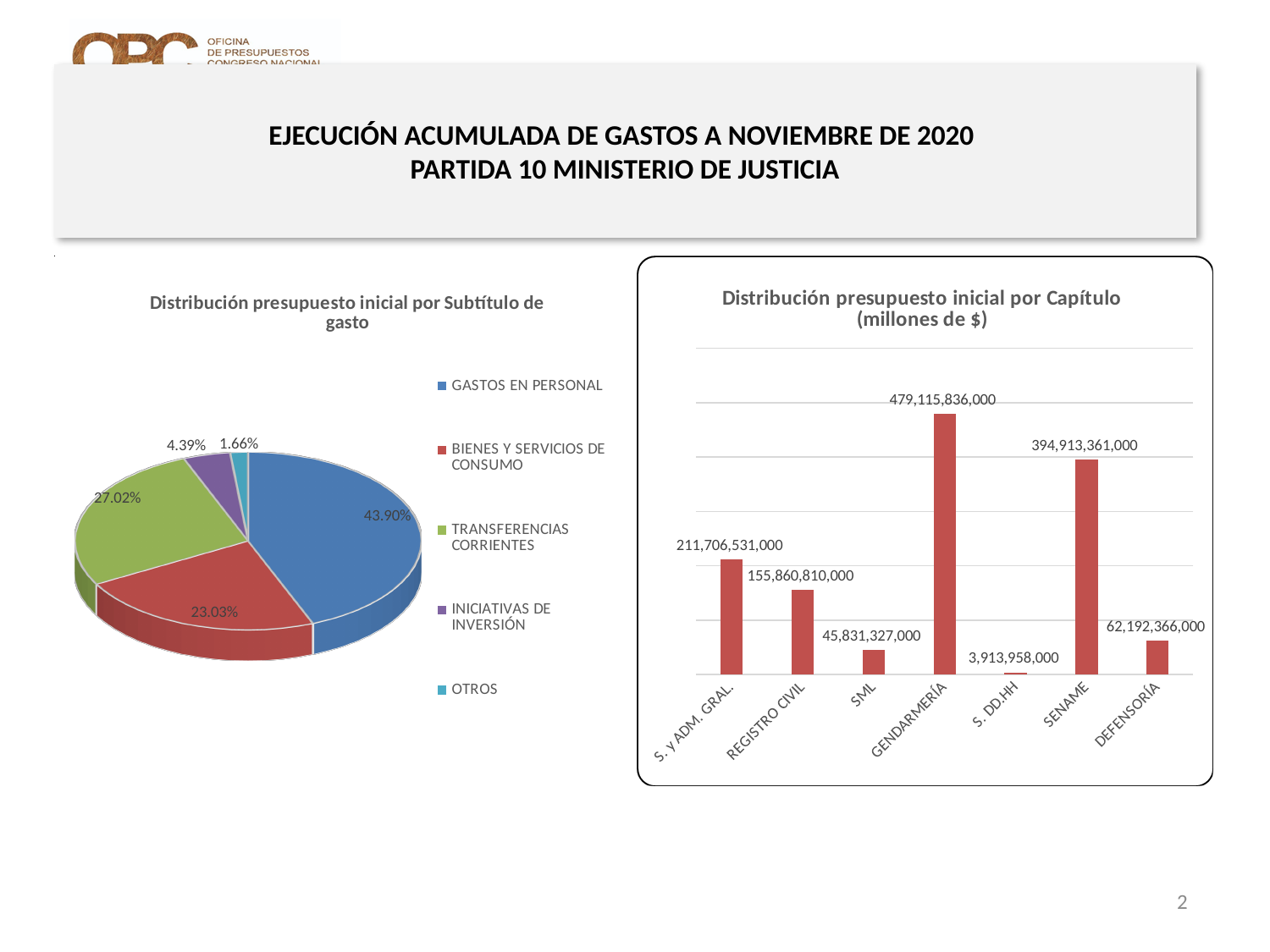
How many categories are shown in the chart 'Distribución presupuesto inicial por Capítulo (millones de $)'? 7 In the chart 'Distribución presupuesto inicial por Capítulo (millones de $)', what is the value for S. DD.HH? 3,913,958,000 What kind of chart is 'Distribución presupuesto inicial por Capítulo (millones de $)'? Bar chart In the chart 'Distribución presupuesto inicial por Capítulo (millones de $)', which category has the highest value? GENDARMERÍA In the chart 'Distribución presupuesto inicial por Capítulo (millones de $)', which category has the lowest value? S. DD.HH In the chart 'Distribución presupuesto inicial por Capítulo (millones de $)', which is larger, the value for REGISTRO CIVIL or the value for DEFENSORÍA? REGISTRO CIVIL In the pie chart 'Distribución presupuesto inicial por Subtítulo de gasto', what share does TRANSFERENCIAS CORRIENTES have? 27.02% In the chart 'Distribución presupuesto inicial por Capítulo (millones de $)', what is the value for SENAME? 394,913,361,000 How many entries does the legend of the pie chart 'Distribución presupuesto inicial por Subtítulo de gasto' list? 5 In the chart 'Distribución presupuesto inicial por Capítulo (millones de $)', what is the value for GENDARMERÍA? 479,115,836,000 In the pie chart 'Distribución presupuesto inicial por Subtítulo de gasto', what share does GASTOS EN PERSONAL have? 43.90% In the chart 'Distribución presupuesto inicial por Capítulo (millones de $)', what is the difference between the values for GENDARMERÍA and SENAME? 84,202,475,000